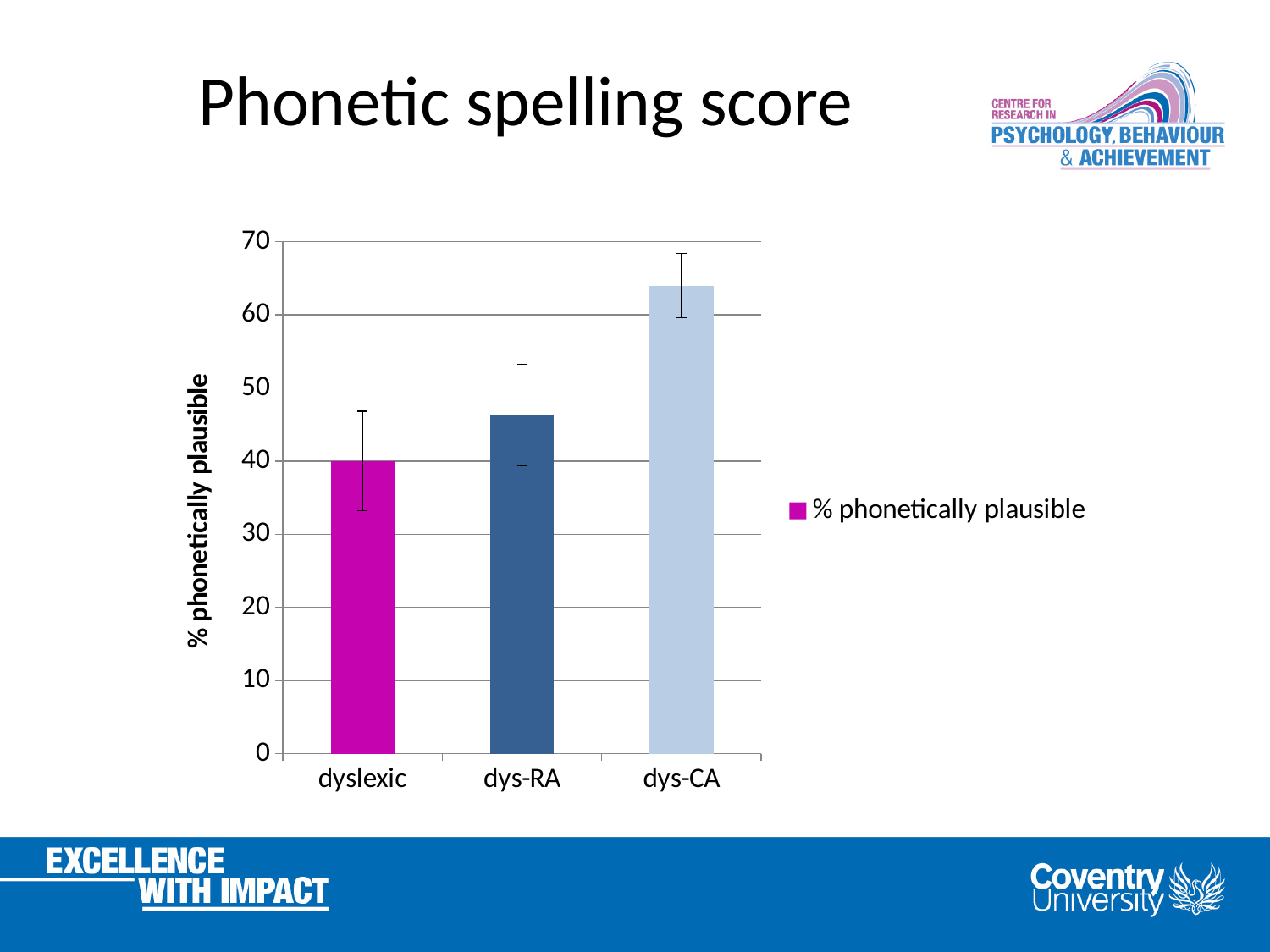
What is the label on the chart's vertical axis? % phonetically plausible Which is larger, the value for dys-CA or the value for dys-RA? dys-CA Do the values rise or fall moving from dyslexic to dys-CA along the x axis? rise Which category has the lowest % phonetically plausible? dyslexic How many categories are shown on the x axis of the chart? 3 Which category has the highest % phonetically plausible? dys-CA Is the value for dys-CA greater or less than 60? greater Is the value for dyslexic greater or less than 50? less How many series does the chart's legend list? 1 Is the value for dys-RA greater or less than 50? less What kind of chart is shown on the slide? bar chart